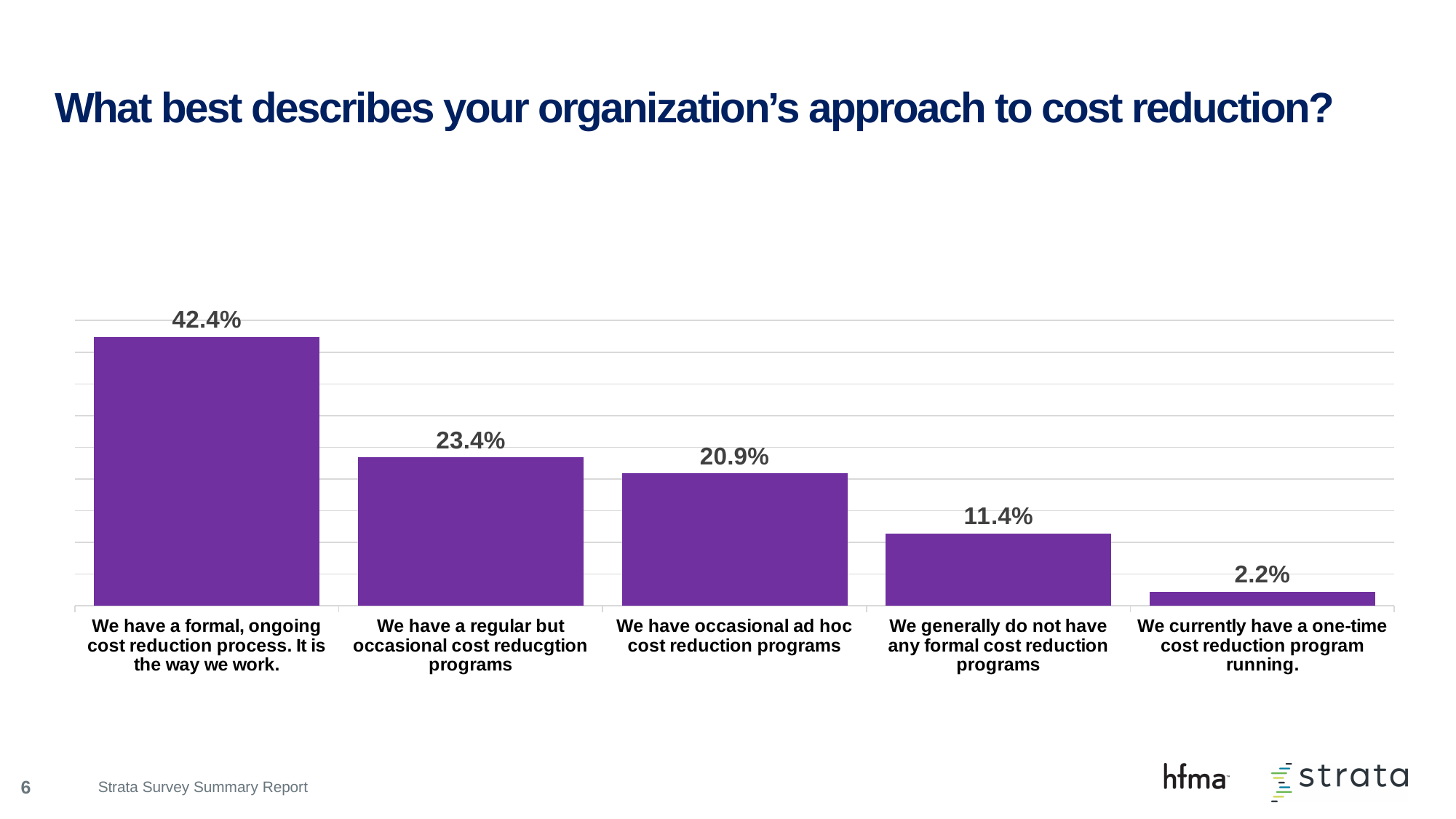
Which approach to cost reduction has the lowest percentage of respondents? We currently have a one-time cost reduction program running. Which is larger: the percentage for occasional ad hoc cost reduction programs or the percentage for generally not having any formal cost reduction programs? We have occasional ad hoc cost reduction programs What type of chart is shown on the slide? Bar chart Do the values rise or fall moving from left to right across the categories? Fall What percentage of respondents said they have a regular but occasional cost reduction programs? 23.4% How many response categories are shown in the chart? 5 What percentage of respondents said they have occasional ad hoc cost reduction programs? 20.9% What percentage of respondents said they have a formal, ongoing cost reduction process? 42.4% What is the difference in percentage points between the formal, ongoing cost reduction process and the regular but occasional cost reduction programs? 19.0 percentage points What percentage of respondents said they generally do not have any formal cost reduction programs? 11.4% Which approach to cost reduction has the highest percentage of respondents? We have a formal, ongoing cost reduction process. It is the way we work. What percentage of respondents said they currently have a one-time cost reduction program running? 2.2%